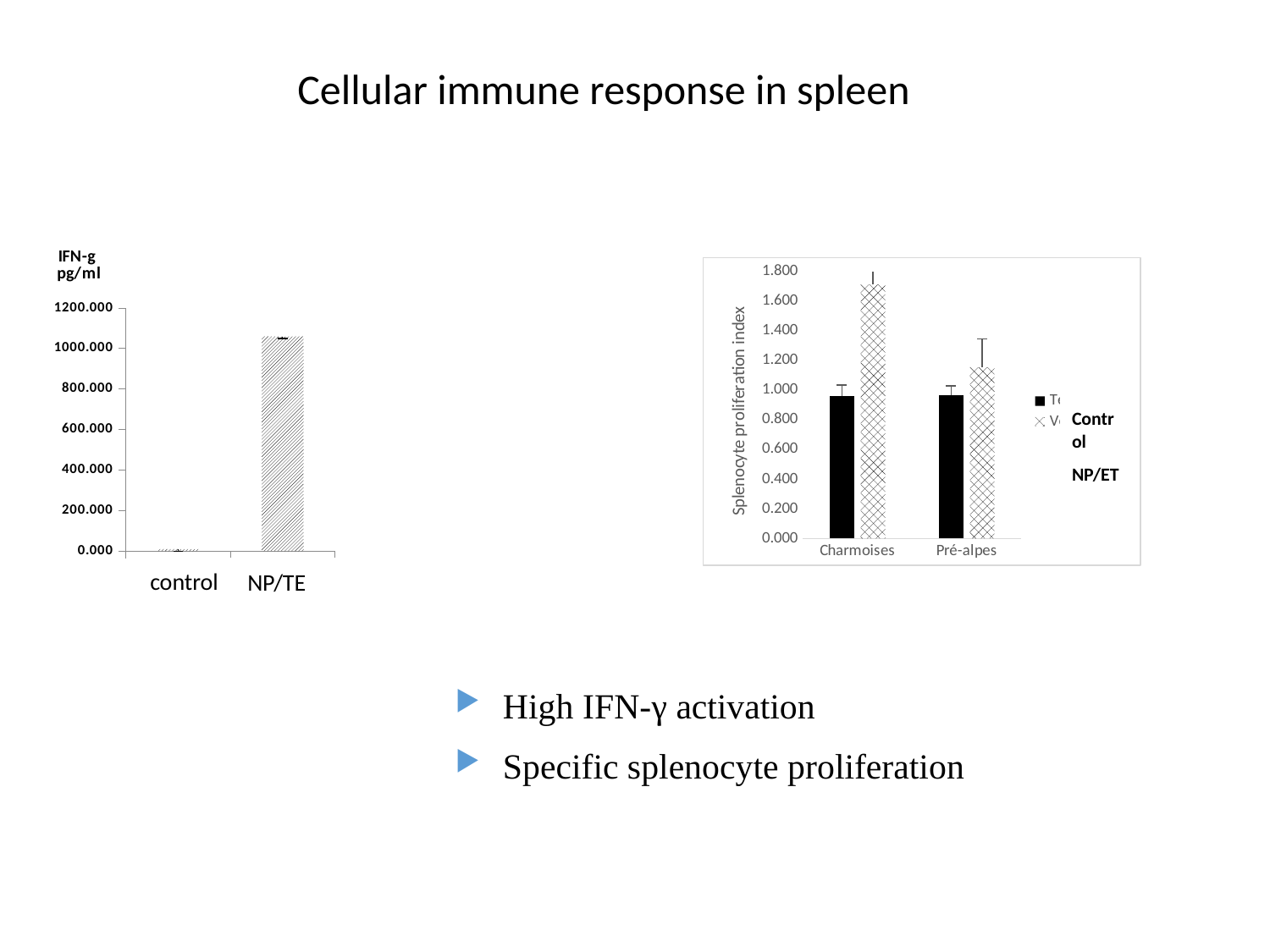
In the left chart (IFN-g pg/ml), is the value for NP/TE greater or less than 1000.000? greater In the right chart (Splenocyte proliferation index), is the Control value for Charmoises greater or less than 1.200? less In the right chart (Splenocyte proliferation index), which breed has the larger NP/ET value, Charmoises or Pré-alpes? Charmoises In the right chart (Splenocyte proliferation index), is the NP/ET value for Pré-alpes greater or less than 1.000? greater How many categories are shown on the x axis of the left chart (IFN-g pg/ml)? 2 What kind of chart is the left chart (IFN-g pg/ml)? bar chart In the left chart (IFN-g pg/ml), which category has the higher value, control or NP/TE? NP/TE How many series does the legend of the right chart (Splenocyte proliferation index) list? 2 In the right chart (Splenocyte proliferation index), which bar is the highest? NP/ET for Charmoises What is the y-axis label of the right chart? Splenocyte proliferation index